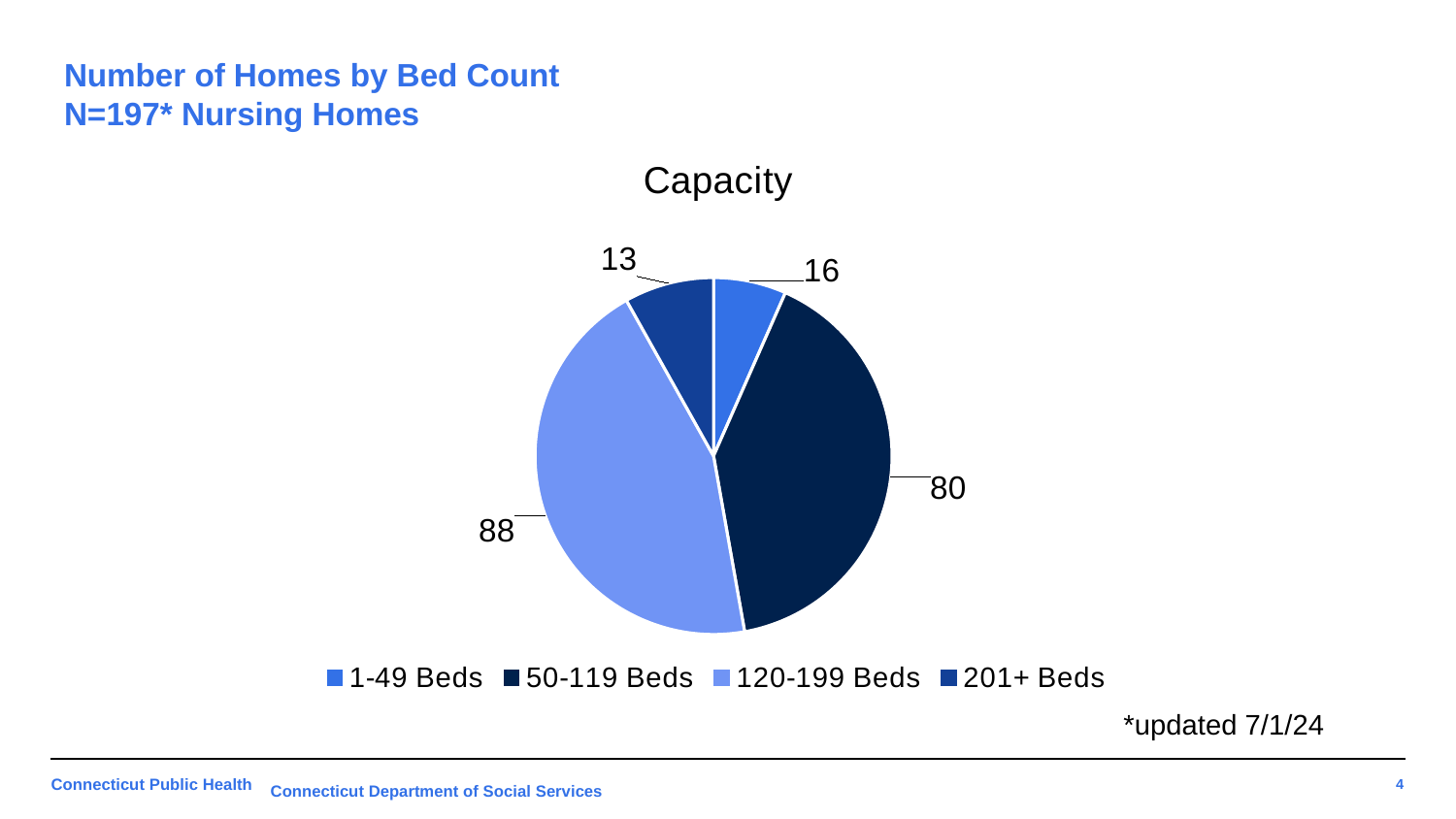
What is the difference between the number of homes with 1-49 beds and those with 201+ beds? 3 What is the title of the pie chart? Capacity Which category has more homes: 1-49 Beds or 201+ Beds? 1-49 Beds How many nursing homes have 1-49 beds? 16 How many bed-count categories does the pie chart show? 4 Which bed-count category has the fewest nursing homes? 201+ Beds Which bed-count category has the most nursing homes? 120-199 Beds How many nursing homes have 120-199 beds? 88 How many nursing homes have 50-119 beds? 80 How many more homes have 120-199 beds than 50-119 beds? 8 What type of chart is shown on the slide? Pie chart How many nursing homes have 201+ beds? 13